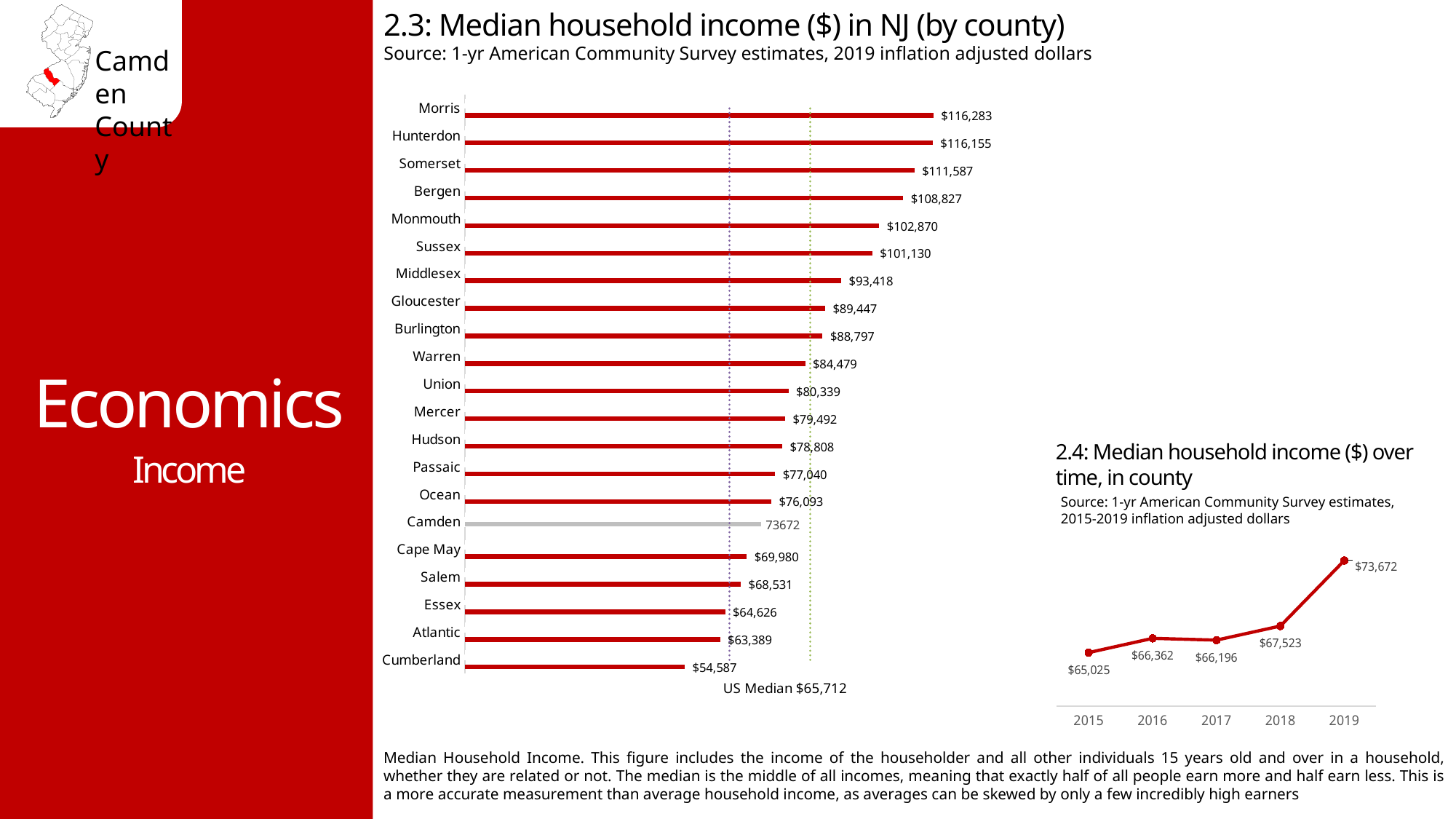
In chart 2.4 (Median household income over time), which year has the highest value? 2019 In chart 2.3 (Median household income by county), how many counties are plotted? 21 In chart 2.3 (Median household income by county), which county has the lowest median household income? Cumberland In chart 2.3 (Median household income by county), which has the higher median household income, Bergen or Monmouth? Bergen In chart 2.4 (Median household income over time), what is the difference between the 2019 and 2015 values? 8,647 What kind of chart is chart 2.3 (Median household income by county)? Bar chart In chart 2.3 (Median household income by county), what is the median household income for Somerset? $111,587 In chart 2.4 (Median household income over time), how many years are plotted? 5 In chart 2.3 (Median household income by county), what is the difference between the values for Camden and Cumberland? 19,085 In chart 2.3 (Median household income by county), what US Median value is noted below the bars? $65,712 In chart 2.3 (Median household income by county), what is the value shown for Camden? 73672 In chart 2.4 (Median household income over time), what is the value for 2018? $67,523